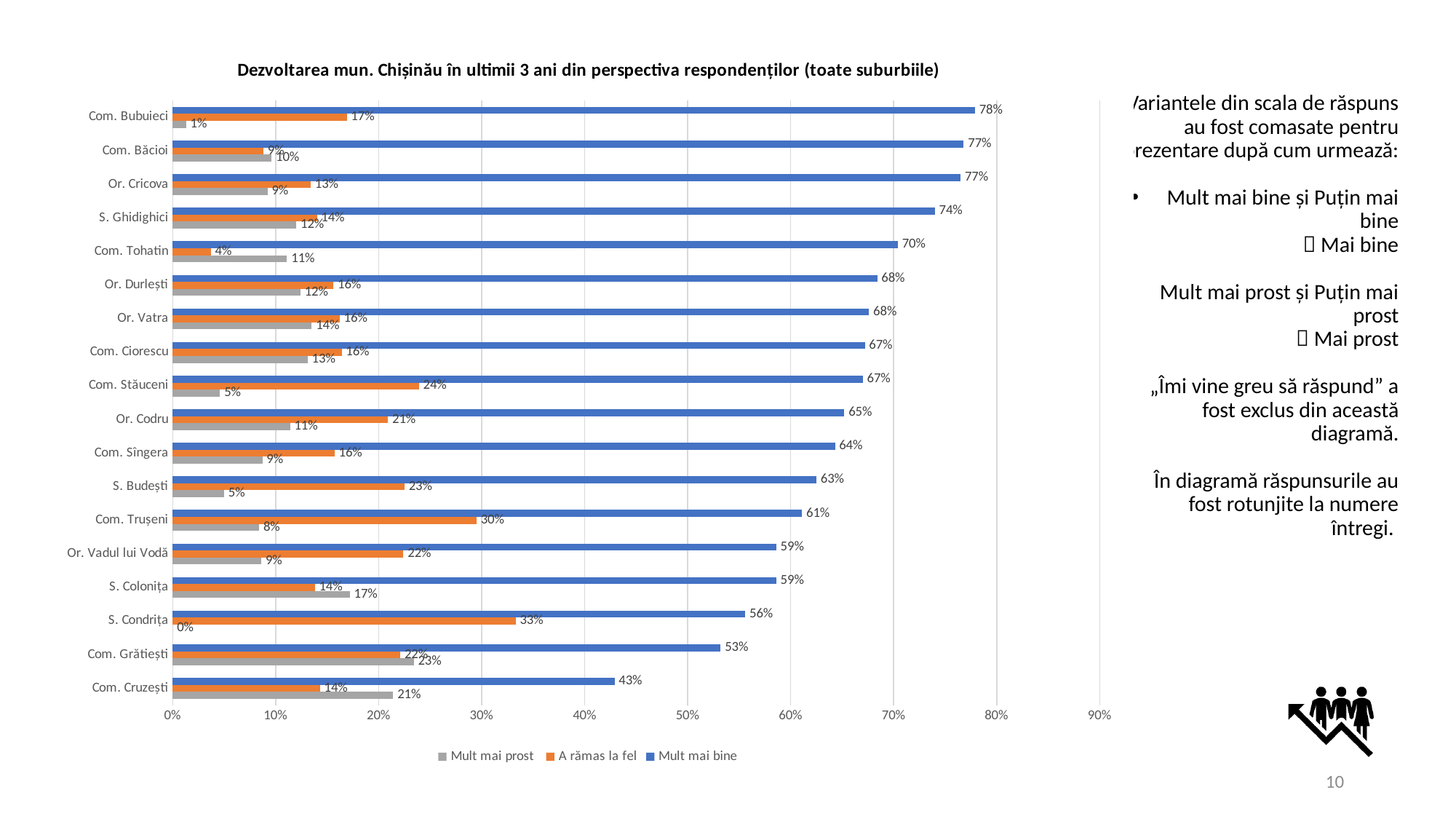
How many series does the legend list? 3 What is the 'Mult mai prost' value for Com. Grătiești? 23% Which category has the highest 'A rămas la fel' value? S. Condrița Which series is shown in blue in the legend? Mult mai bine How many categories (localities) are shown on the chart? 18 What is the 'A rămas la fel' value for S. Condrița? 33% What is the 'Mult mai bine' value for Com. Bubuieci? 78% What is the difference between the 'Mult mai bine' values for Com. Bubuieci and Com. Cruzești? 35% Which category has the lowest 'Mult mai bine' value? Com. Cruzești What kind of chart is shown on the slide? Bar chart Is the 'Mult mai bine' value for Com. Tohatin greater or less than 60%? greater Which is larger: the 'A rămas la fel' value for Com. Trușeni or for Com. Stăuceni? Com. Trușeni